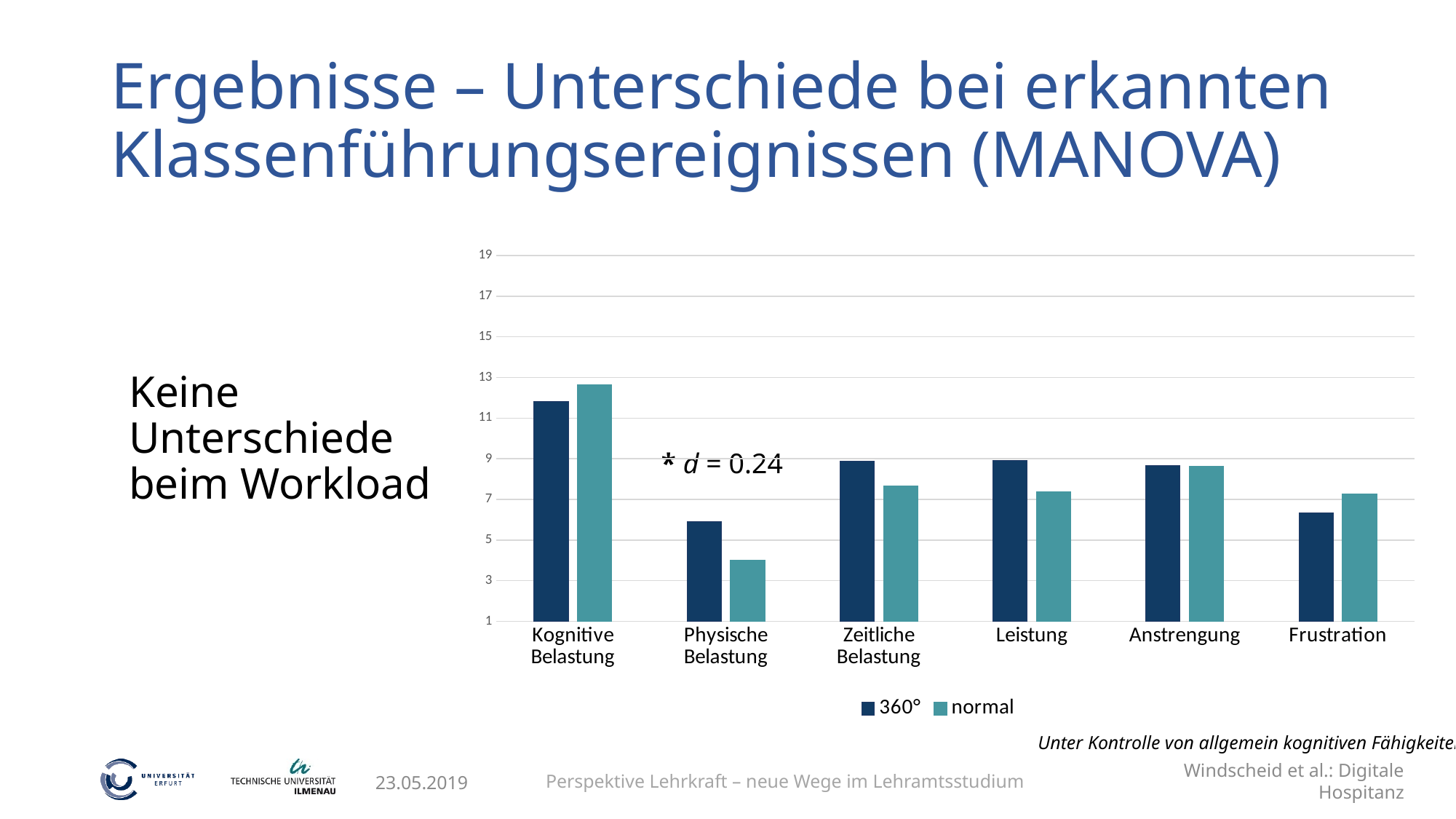
Which category has the lowest value for the normal series? Physische Belastung For Frustration, which series has the larger value, 360° or normal? normal How many categories are shown on the x axis of the chart? 6 How many series does the chart's legend list? 2 What kind of chart is shown on the slide? bar chart For Physische Belastung, which series has the larger value, 360° or normal? 360° What are the two series named in the legend? 360° and normal Is the value for the normal series in Kognitive Belastung greater or less than 11? greater Is the value for the 360° series in Leistung greater or less than 7? greater Is the value for the normal series in Physische Belastung greater or less than 5? less Which category has the highest value for the 360° series? Kognitive Belastung Which category has the lowest value for the 360° series? Physische Belastung